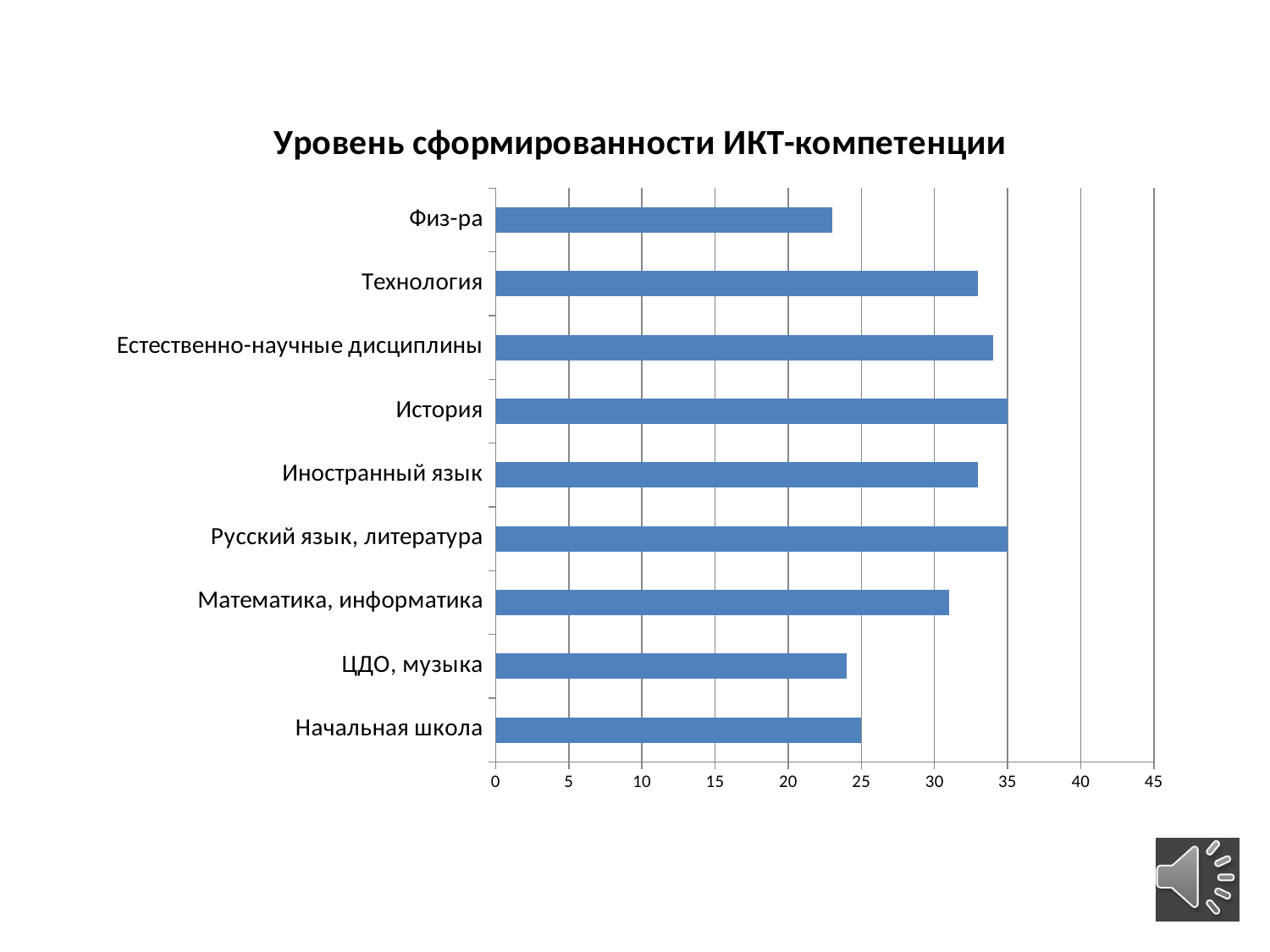
Is the value for Математика, информатика greater or less than 30? greater Is the value for Технология greater or less than 30? greater What is the value for Начальная школа? 25 Which is larger, the value for Технология or the value for ЦДО, музыка? Технология What is the value for История? 35 What kind of chart is shown on the slide? bar chart Which is larger, the value for История or the value for Физ-ра? История What is the title of the chart? Уровень сформированности ИКТ-компетенции Is the value for ЦДО, музыка greater or less than 25? less How many categories are plotted in the chart? 9 What is the value for Русский язык, литература? 35